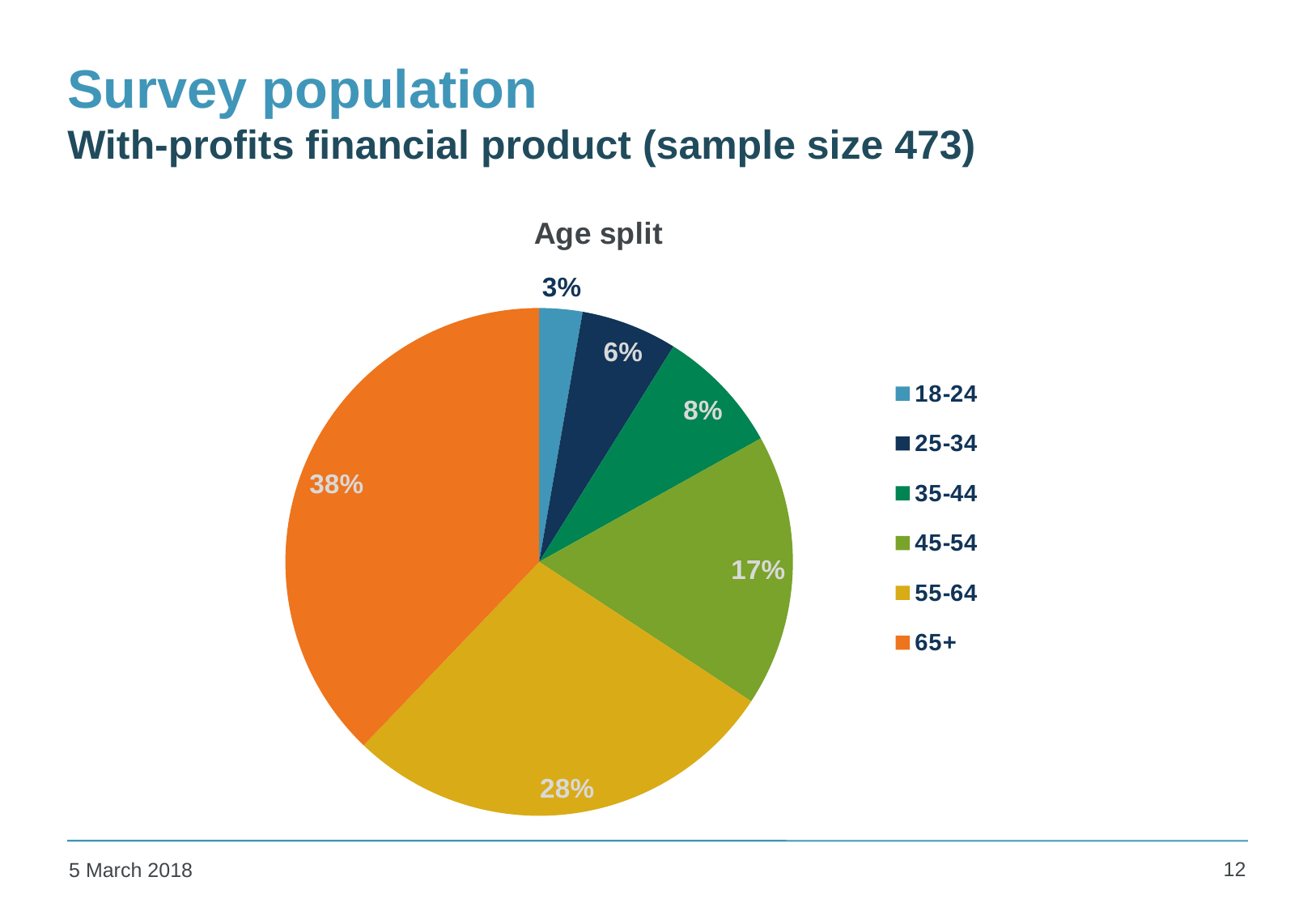
How many age groups are shown in the pie chart? 6 What share of the pie does the 65+ age group represent? 38% Which age group has the smallest share of the pie? 18-24 What is the value shown for the 18-24 age group? 3% Which age group has the largest share of the pie? 65+ What kind of chart is shown on the slide? Pie chart What is the value shown for the 35-44 age group? 8% Which is larger, the share for 45-54 or the share for 25-34? 45-54 What is the title of the chart? Age split What colour is the slice for the 55-64 age group? Yellow What is the difference in percentage points between the 65+ and 55-64 groups? 10 What is the value shown for the 55-64 age group? 28%